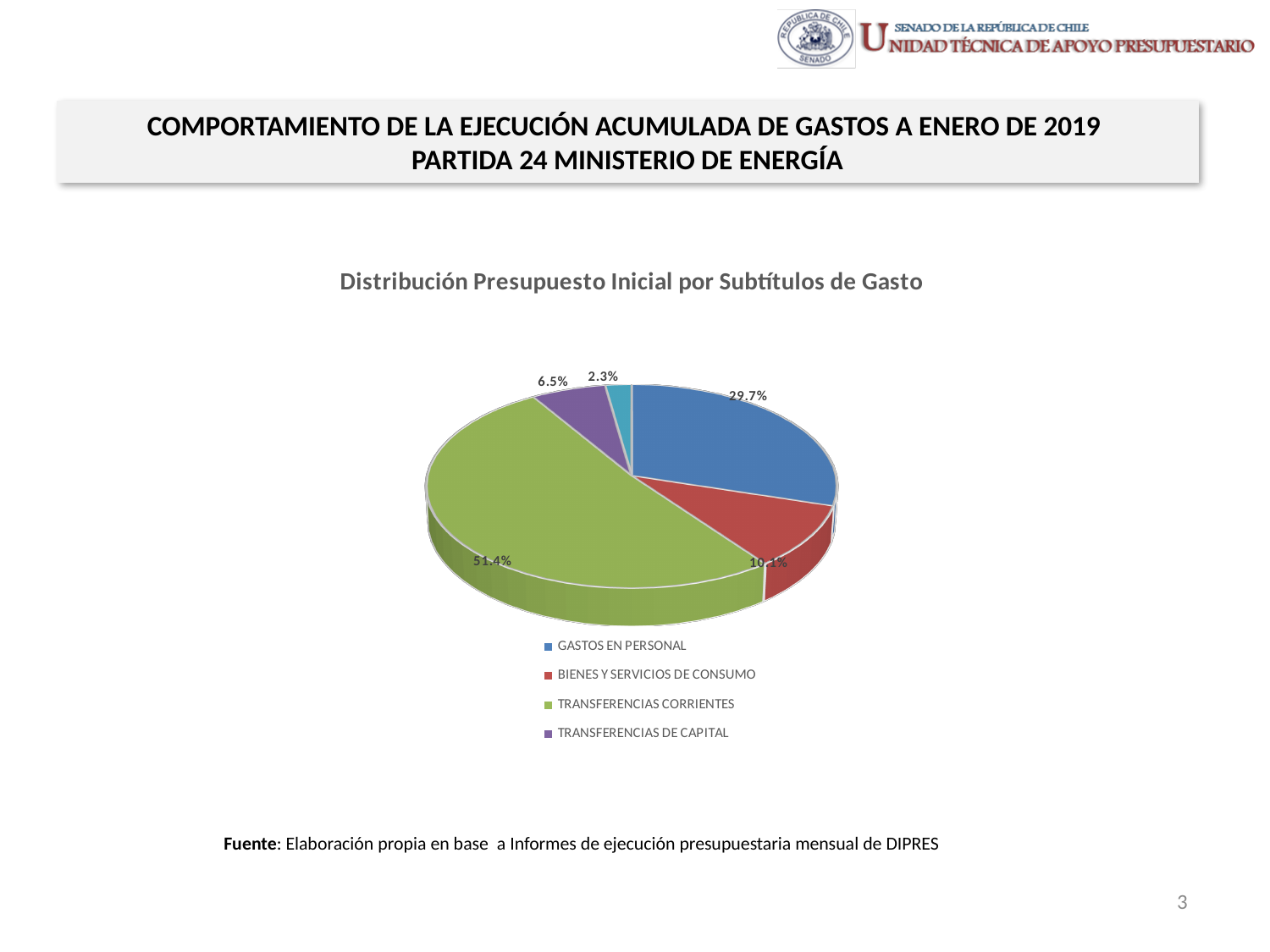
Which has a larger share: GASTOS EN PERSONAL or BIENES Y SERVICIOS DE CONSUMO? GASTOS EN PERSONAL What is the title of the pie chart? Distribución Presupuesto Inicial por Subtítulos de Gasto How many slices does the pie chart have? 5 What is the smallest percentage labeled on the pie chart? 2.3% How many entries does the chart legend list? 4 Which subtítulo has the largest share of the initial budget? TRANSFERENCIAS CORRIENTES What kind of chart is shown on the slide? pie chart How many percentage points larger is the share of TRANSFERENCIAS CORRIENTES than that of GASTOS EN PERSONAL? 21.7 percentage points What percentage of the initial budget corresponds to GASTOS EN PERSONAL? 29.7% What percentage of the initial budget corresponds to BIENES Y SERVICIOS DE CONSUMO? 10.1% What percentage of the initial budget corresponds to TRANSFERENCIAS DE CAPITAL? 6.5% What percentage of the initial budget corresponds to TRANSFERENCIAS CORRIENTES? 51.4%